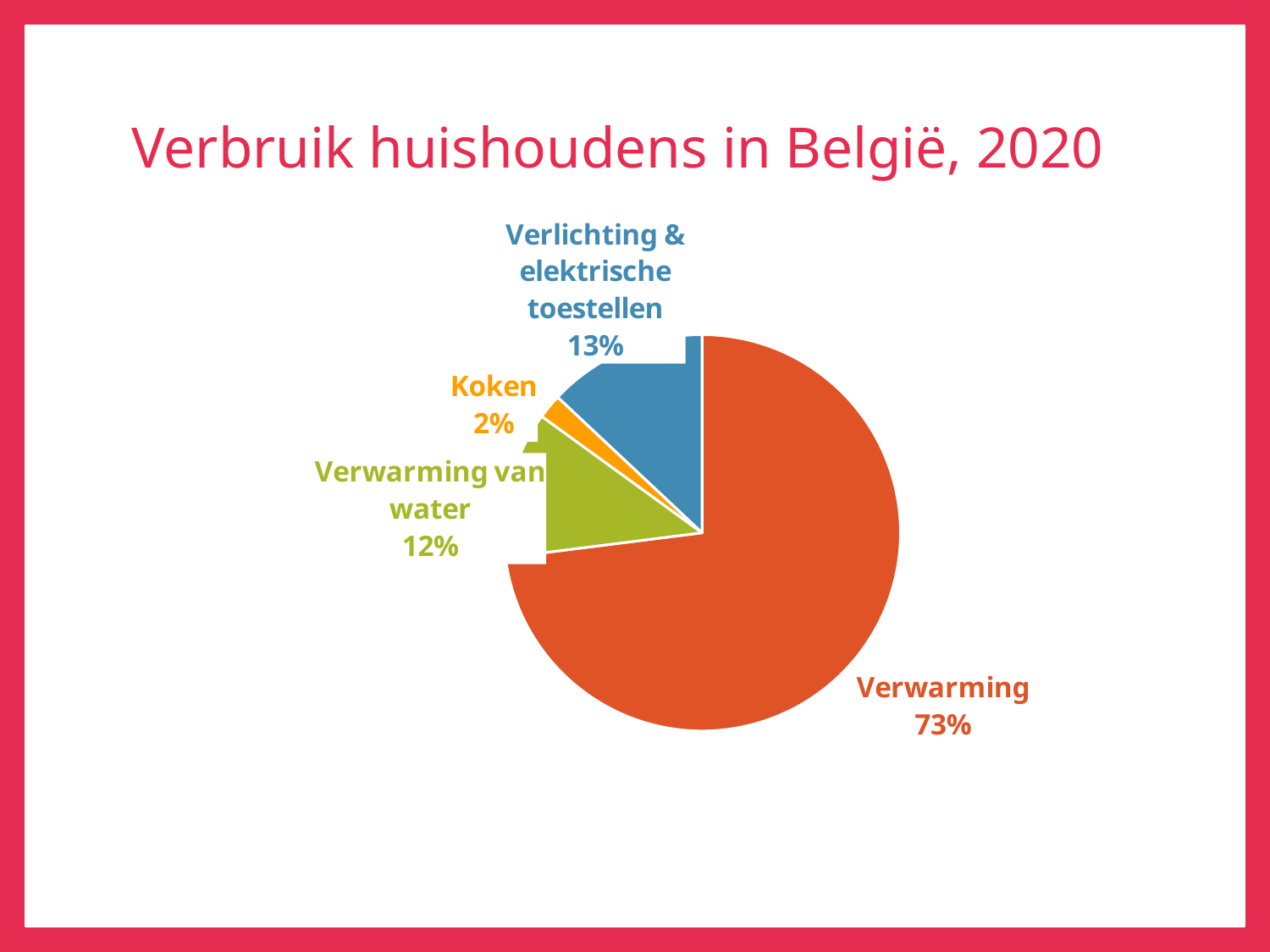
What is the title of the chart? Verbruik huishoudens in België, 2020 Which is larger, the share for Verlichting & elektrische toestellen or the share for Verwarming van water? Verlichting & elektrische toestellen How many categories are shown in the pie chart? 4 Which category has the largest share of the pie? Verwarming What type of chart is shown on the slide? Pie chart What percentage is shown for Verwarming van water? 12% Which category has the smallest share of the pie? Koken What share of household consumption does Verwarming account for? 73% What percentage is shown for Verlichting & elektrische toestellen? 13% What percentage is shown for Koken? 2% What is the difference in percentage points between Verlichting & elektrische toestellen and Koken? 11 What is the difference in percentage points between Verwarming and Verwarming van water? 61